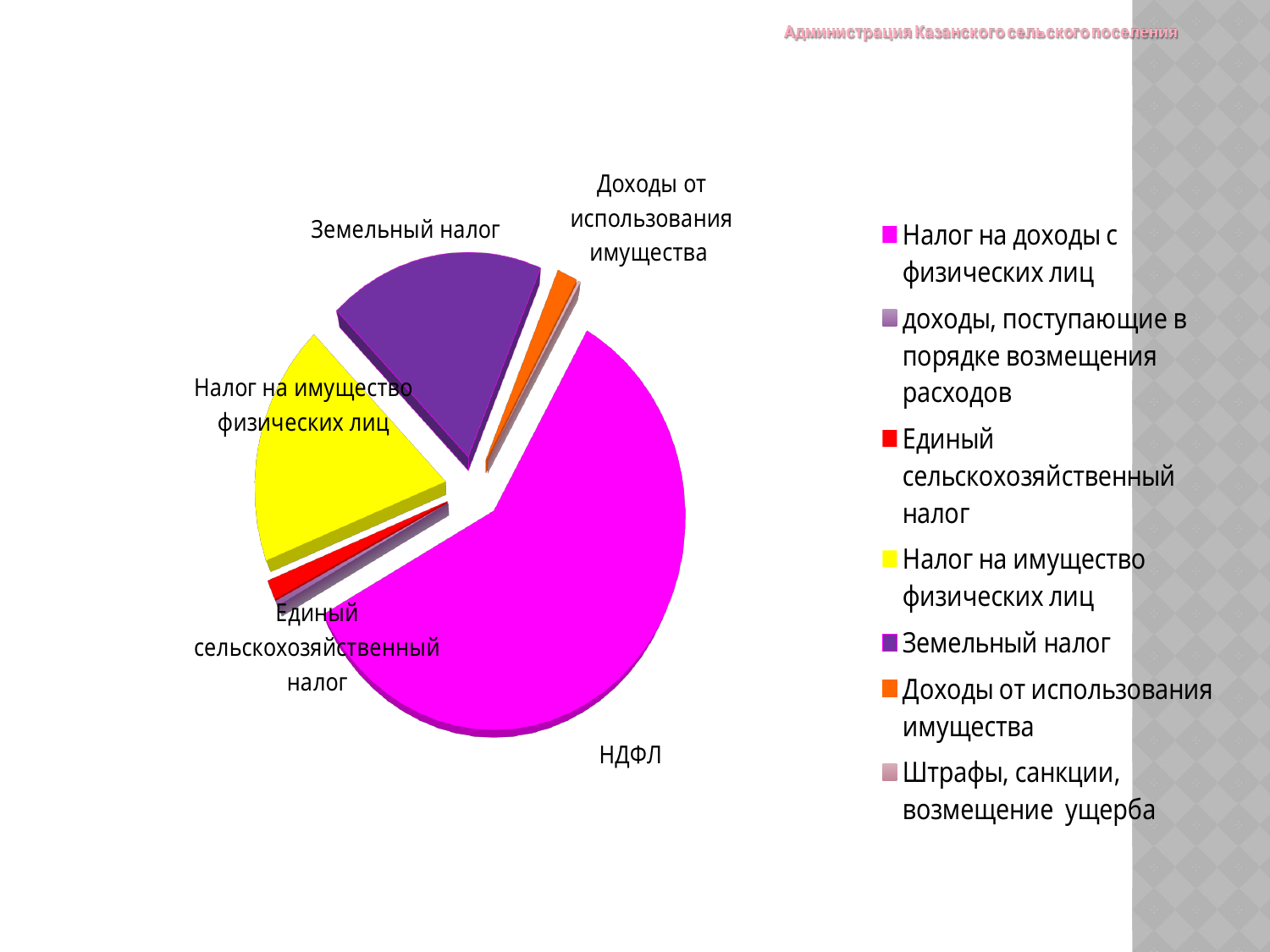
Which slice is larger: НДФЛ or Налог на имущество физических лиц? НДФЛ How many entries does the chart's legend list? 7 What colour is the НДФЛ slice? magenta Which category has the largest slice of the pie? НДФЛ What colour does the legend use for Земельный налог? purple Does the НДФЛ slice take up more or less than half of the pie? more Which slice is larger: Налог на имущество физических лиц or Единый сельскохозяйственный налог? Налог на имущество физических лиц What kind of chart is shown on the slide? pie chart How many slices are labelled directly on the pie? 5 Which slice is larger: Земельный налог or Доходы от использования имущества? Земельный налог